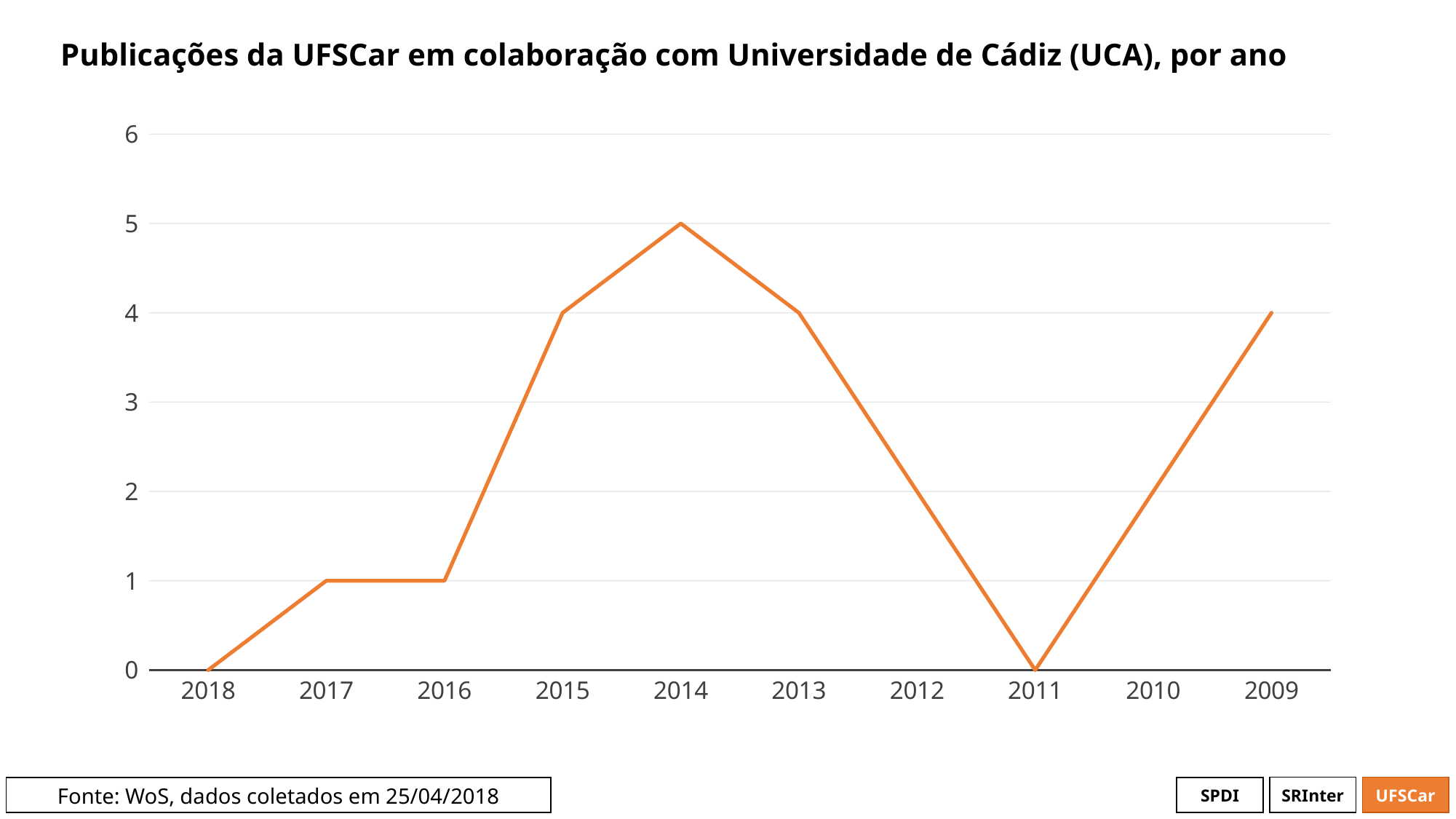
Which year has the highest number of publications? 2014 How many years are shown on the x axis of the chart? 10 What is the title of the chart? Publicações da UFSCar em colaboração com Universidade de Cádiz (UCA), por ano What is the number of publications in 2014? 5 Is the value for 2012 greater or less than 3? less What type of chart is shown on the slide? Line chart What is the number of publications in 2017? 1 What is the number of publications in 2015? 4 What is the difference between the number of publications in 2014 and in 2013? 1 Does the line rise or fall from 2018 to 2014 along the x axis? Rises Which year has more publications, 2009 or 2016? 2009 What is the number of publications in 2018? 0